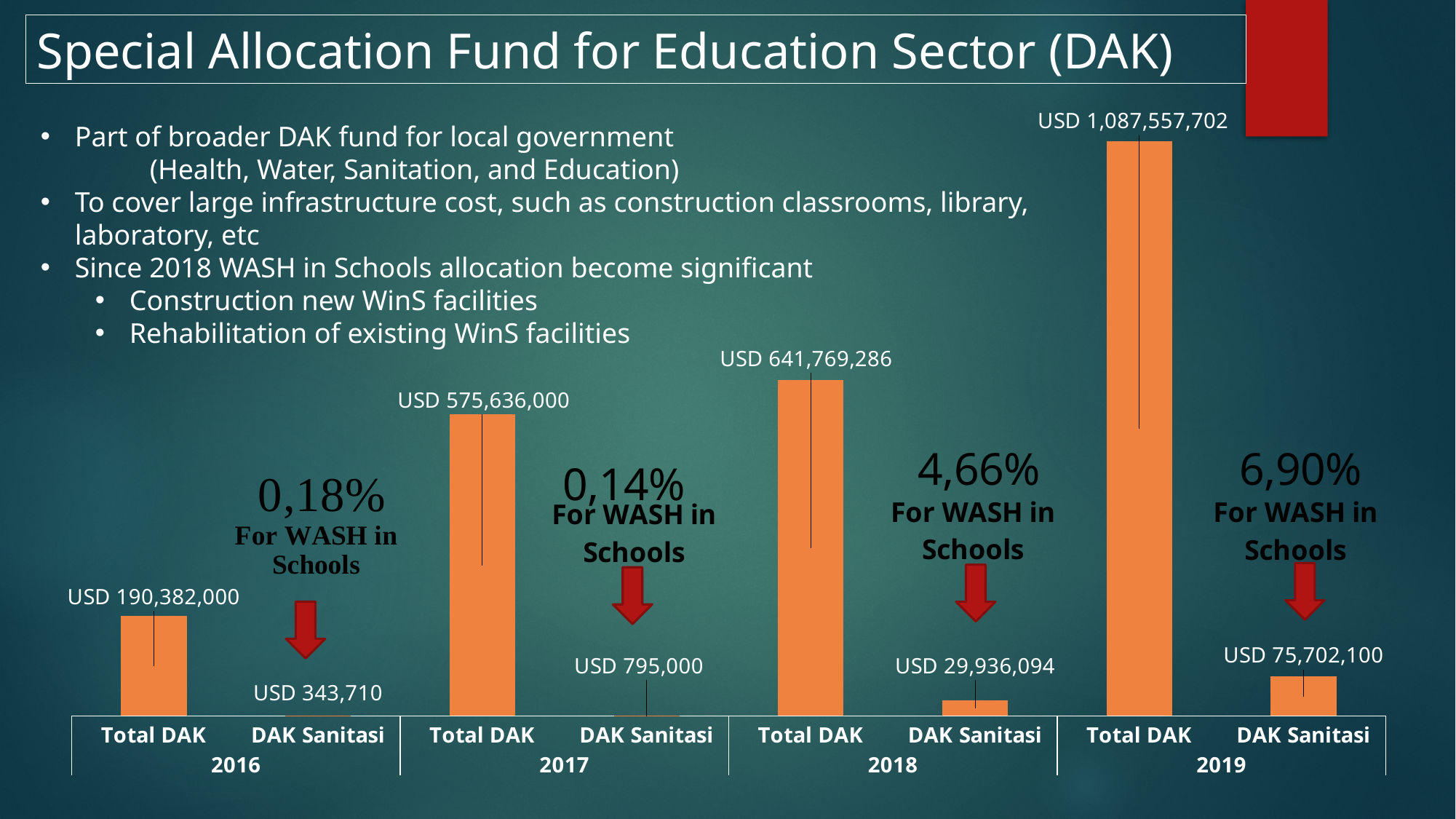
What is the Total DAK value for 2019? USD 1,087,557,702 What is the DAK Sanitasi value for 2017? USD 795,000 Which year has the lowest DAK Sanitasi value? 2016 What is the Total DAK value for 2016? USD 190,382,000 Which is larger, the Total DAK value for 2017 or the Total DAK value for 2018? 2018 What is the difference between the DAK Sanitasi values for 2019 and 2018? USD 45,766,006 What kind of chart is shown on the slide? Bar chart What is the difference between the Total DAK values for 2019 and 2018? USD 445,788,416 How many bars are plotted in the chart? 8 What is the DAK Sanitasi value for 2018? USD 29,936,094 Does the Total DAK value rise or fall from 2016 to 2019? Rise Which year has the highest Total DAK value? 2019